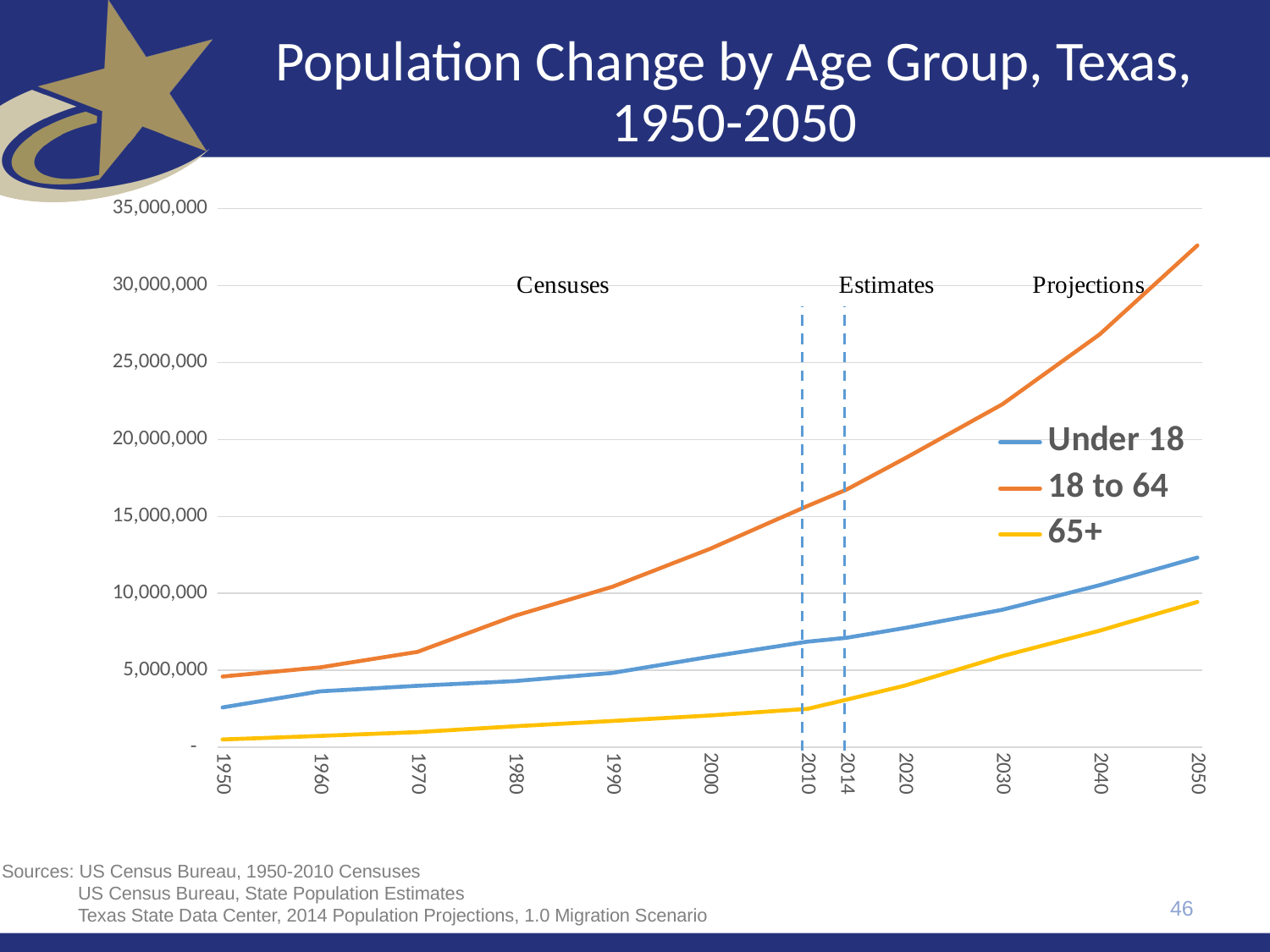
Which age group has the lowest population in 1950? 65+ Is the value for the Under 18 group in 1950 greater or less than 5,000,000? less Is the value for the 18 to 64 group in 2000 greater or less than 15,000,000? less What kind of chart is shown on the slide? line chart How many years are labeled along the x axis? 12 How many series does the legend list? 3 In 2050, which is larger: the Under 18 population or the 65+ population? Under 18 Is the value for the 65+ group in 2050 greater or less than 10,000,000? less Does the population of the 18 to 64 group rise or fall from 1950 to 2050? rise What are the three labeled periods shown across the top of the chart? Censuses, Estimates, Projections Which age group has the highest population in 2050? 18 to 64